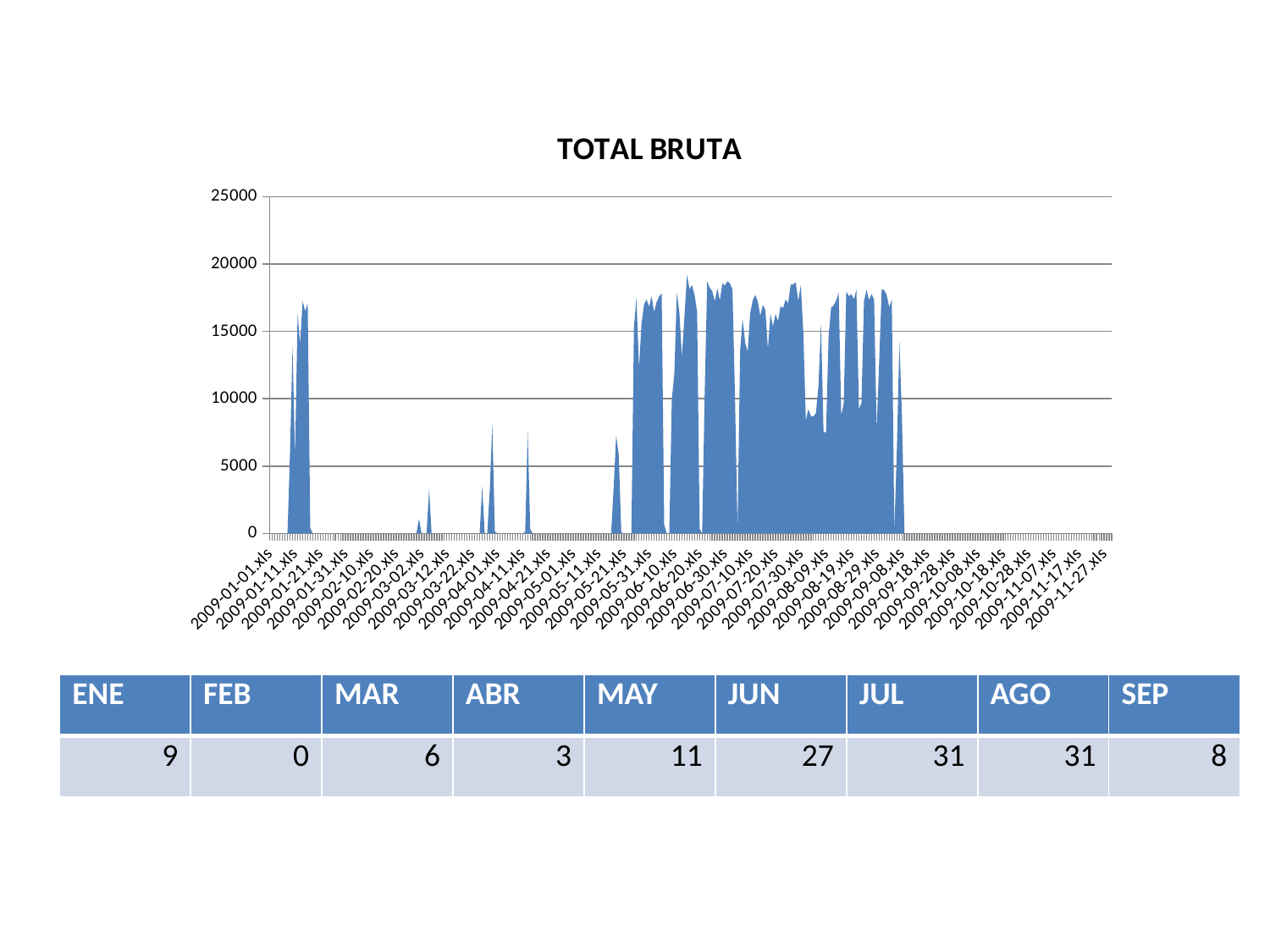
Is the highest value reached on the chart greater or less than 15000? greater Is the peak reached near 2009-04-11.xls greater or less than 10000? less What colour is the plotted area in the chart? blue Is the value for 2009-11-17.xls greater or less than 5000? less What is the title of the chart? TOTAL BRUTA What kind of chart is shown on the slide? area chart